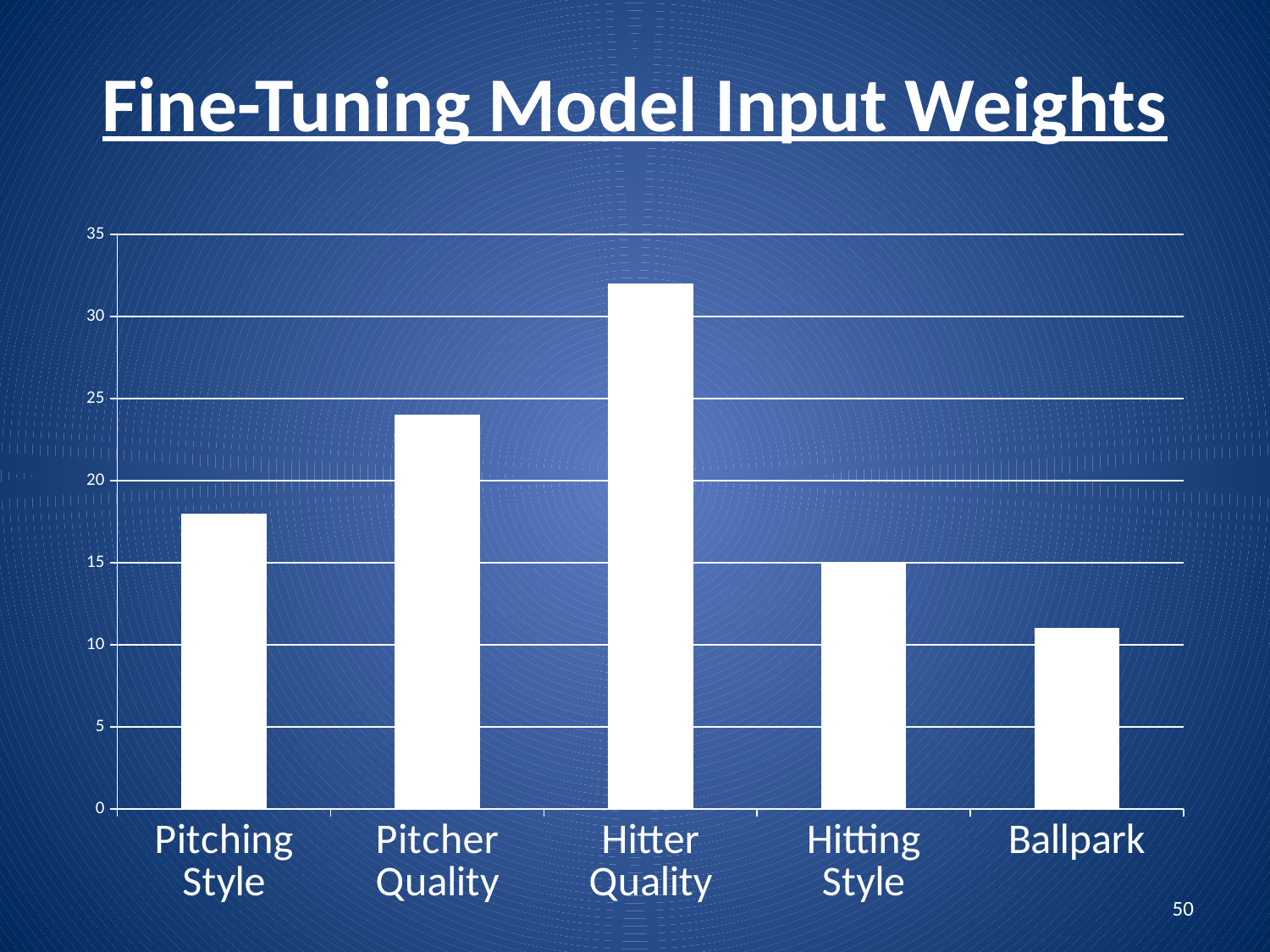
Is the value for Pitching Style greater or less than 20? less Which is larger, the value for Hitting Style or the value for Ballpark? Hitting Style What is the value for Hitting Style? 15 Which category has the highest bar in the chart? Hitter Quality What is the title of the slide containing the chart? Fine-Tuning Model Input Weights Is the value for Ballpark greater or less than 15? less Which is larger, the value for Pitcher Quality or the value for Pitching Style? Pitcher Quality Is the value for Pitcher Quality greater or less than 20? greater What kind of chart is shown on the slide? bar chart How many categories are shown on the x axis of the chart? 5 Which category has the lowest bar in the chart? Ballpark